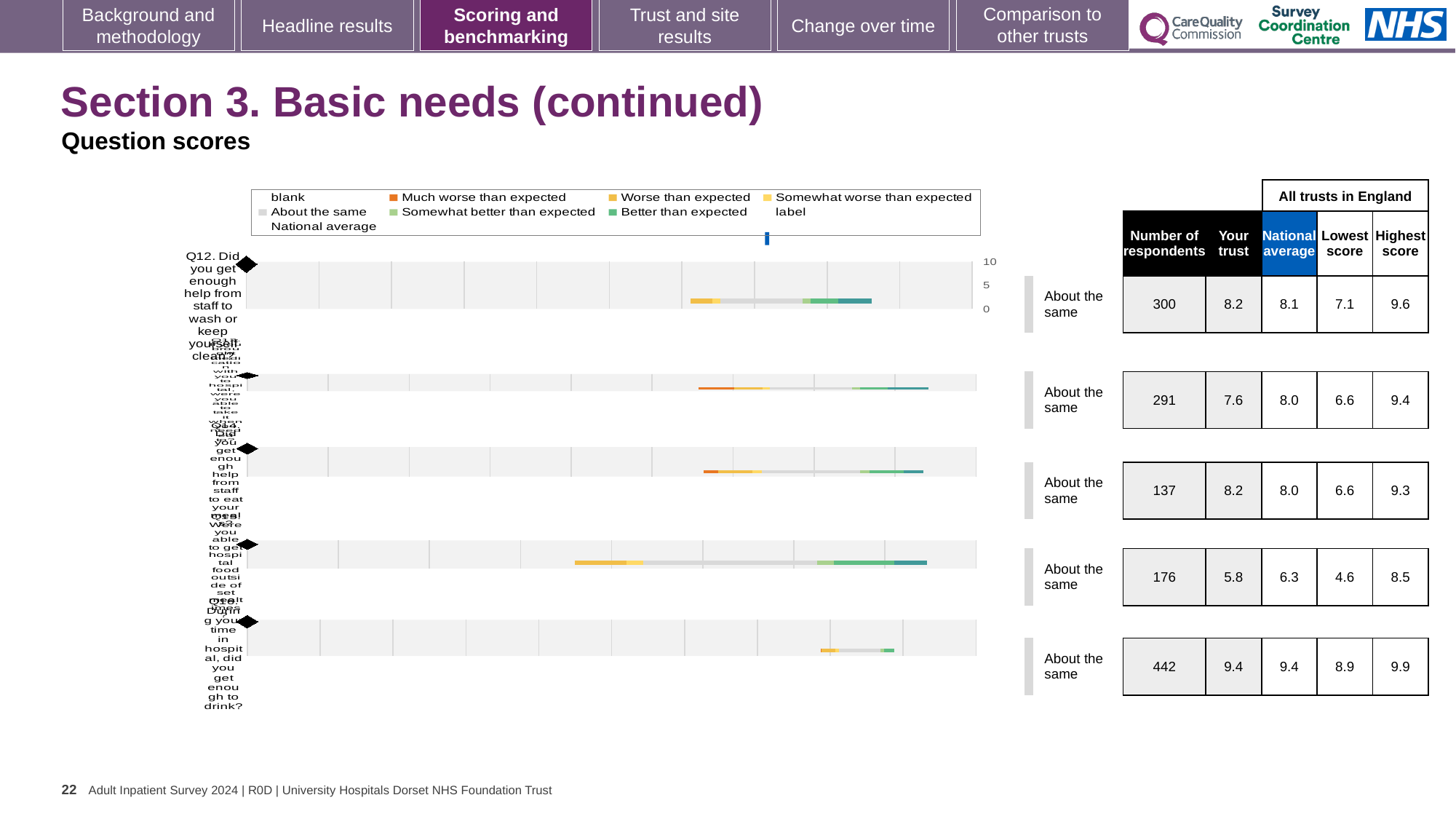
Are the bars in the chart drawn horizontally or vertically? horizontally Which colour does the legend use for 'Much worse than expected'? orange How many question categories (bars) are plotted in the chart? 5 What kind of chart is shown on the slide? bar chart Which colour does the legend use for 'About the same'? grey How many entries does the chart legend list? 9 What is the last question category listed at the bottom of the chart? Q16. During your time in hospital, did you get enough to drink? What is the first question category listed at the top of the chart? Q12. Did you get enough help from staff to wash or keep yourself clean?